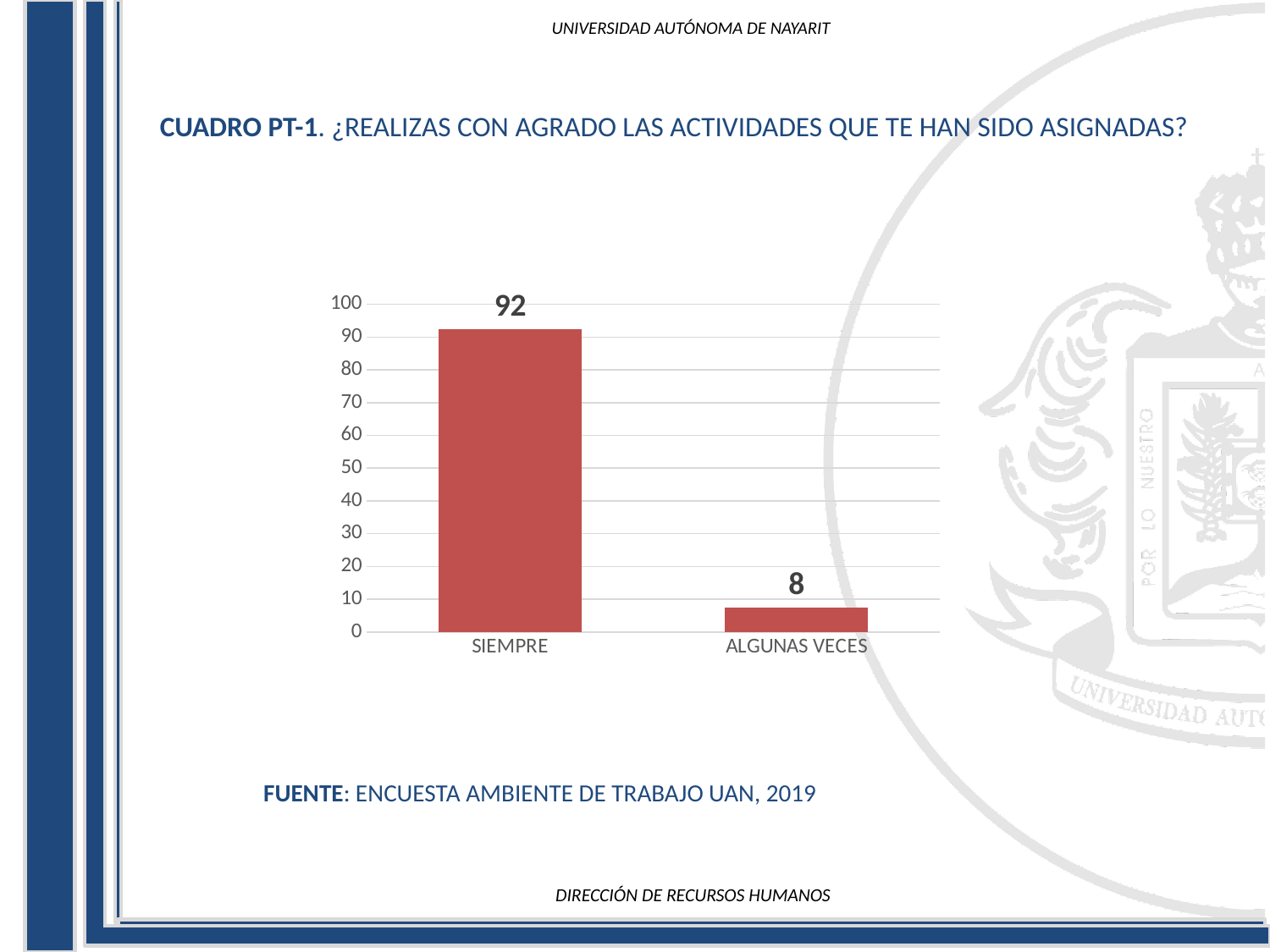
Which category has the lowest value? ALGUNAS VECES Which category has the highest value? SIEMPRE How many categories are shown on the x axis? 2 What is the total of the two values shown in the chart? 100 Is the value for SIEMPRE greater or less than 90? greater What is the source cited below the chart? ENCUESTA AMBIENTE DE TRABAJO UAN, 2019 What kind of chart is shown on the slide? bar chart What is the difference between the values for SIEMPRE and ALGUNAS VECES? 84 What is the value for SIEMPRE? 92 Is the value for ALGUNAS VECES greater or less than 10? less Which is larger, the value for SIEMPRE or the value for ALGUNAS VECES? SIEMPRE What is the value for ALGUNAS VECES? 8